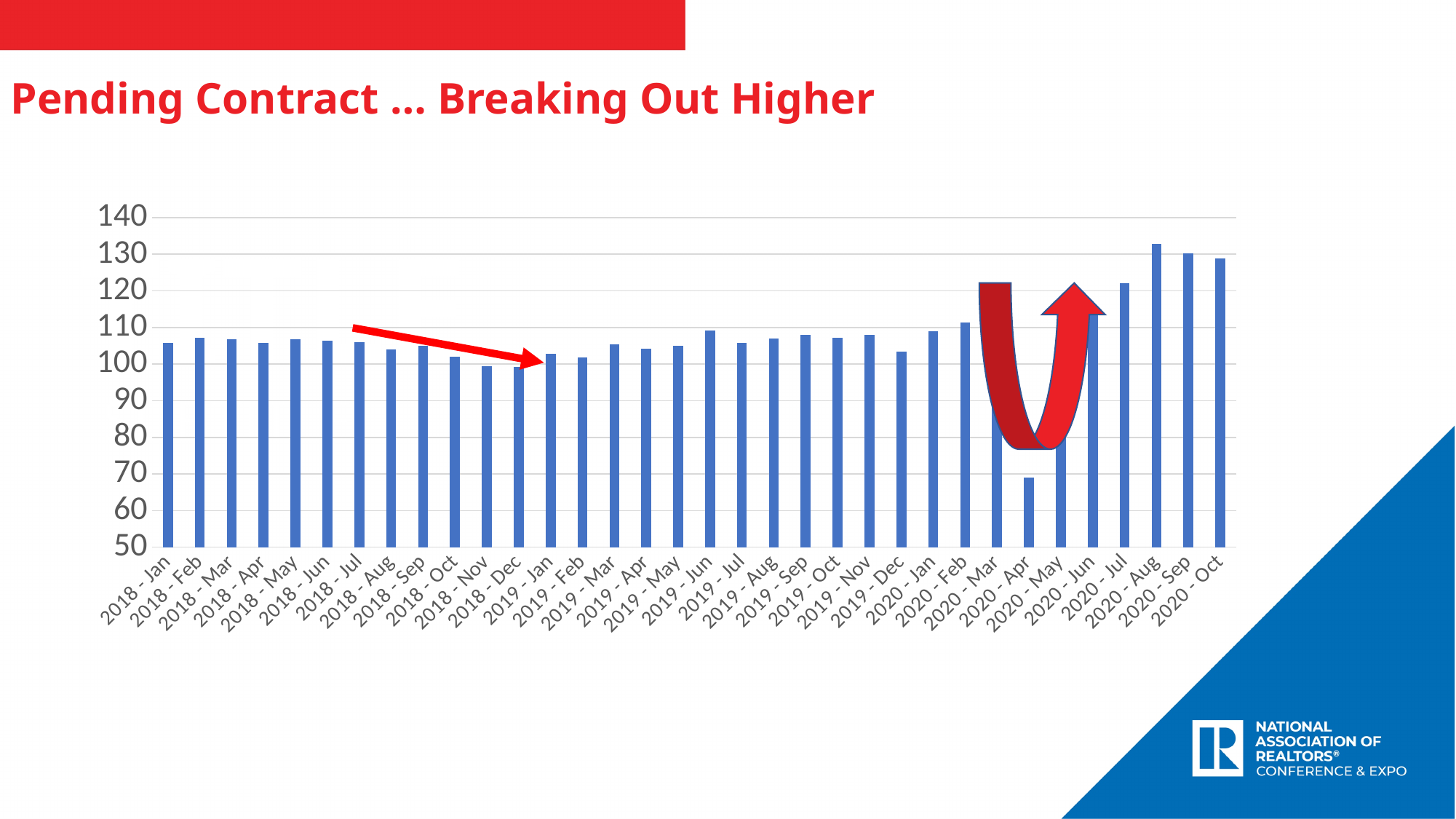
Which is larger, the value for 2019 - Apr or the value for 2020 - Apr? 2019 - Apr How many monthly bars are plotted in the chart? 34 Do the values rise or fall from 2020 - Apr to 2020 - Aug? Rise Is the value for 2020 - Jul greater or less than 110? greater Which is larger, the value for 2018 - Oct or the value for 2020 - Oct? 2020 - Oct Is the value for 2020 - Apr greater or less than 80? less Which month has the highest value in the chart? 2020 - Aug What is the title of the slide's chart? Pending Contract … Breaking Out Higher Is the value for 2019 - Jun greater or less than 100? greater Which month has the lowest value in the chart? 2020 - Apr What kind of chart is shown on the slide? Bar chart